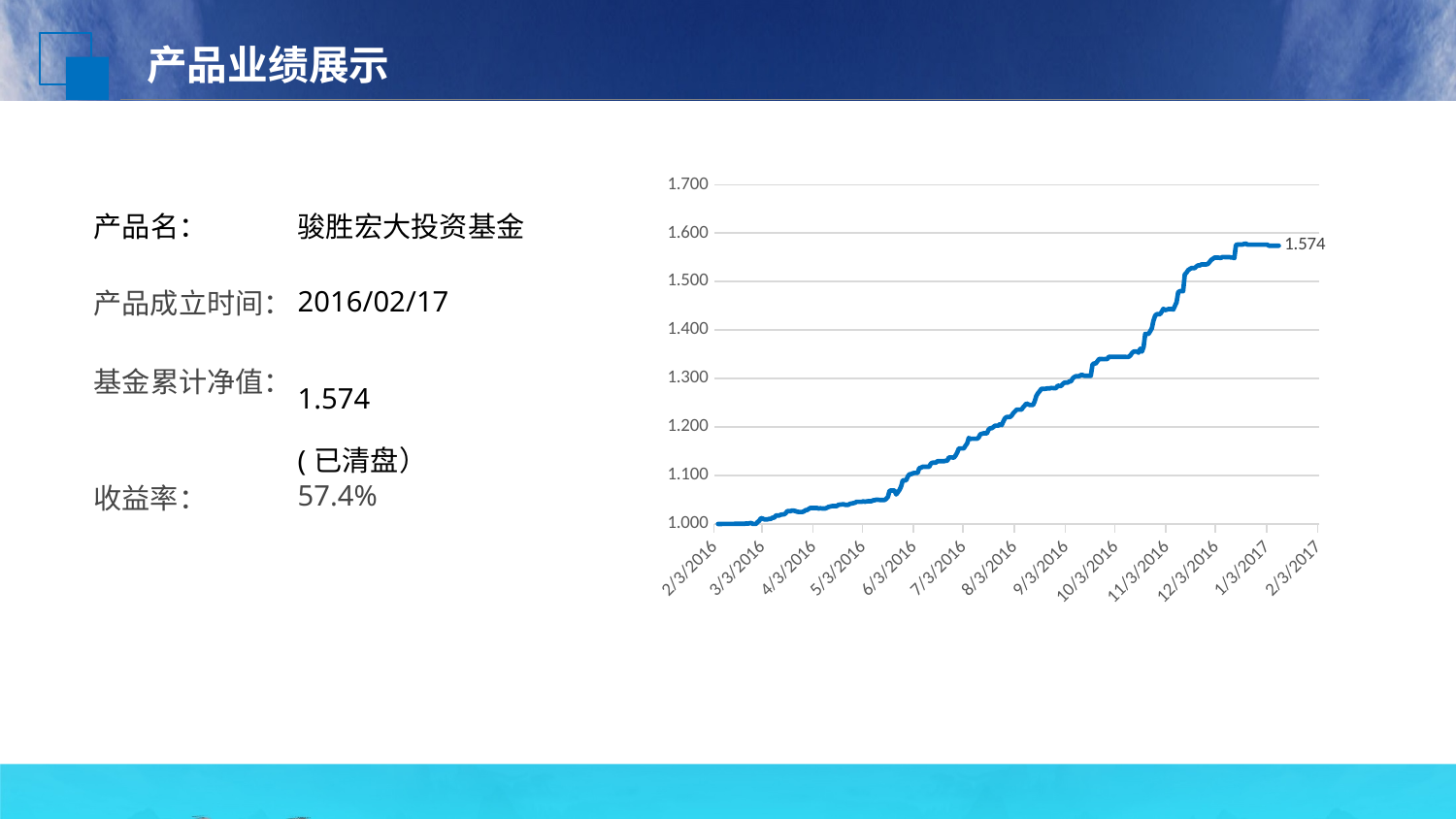
What is the difference between the final labeled value 1.574 and the starting value of 1.000? 0.574 Which is larger, the value at 12/3/2016 or the value at 6/3/2016? 12/3/2016 Is the value at 7/3/2016 greater or less than 1.200? less At which date label is the line at its lowest point? 2/3/2016 How many date labels are shown on the x axis? 13 What kind of chart is shown on the slide? line chart Is the value at 1/3/2017 greater or less than 1.500? greater What is the last date label on the x axis? 2/3/2017 What is the highest value shown on the y axis? 1.700 Does the line generally rise or fall from left to right along the x axis? rise What is the value shown by the data label at the end of the line? 1.574